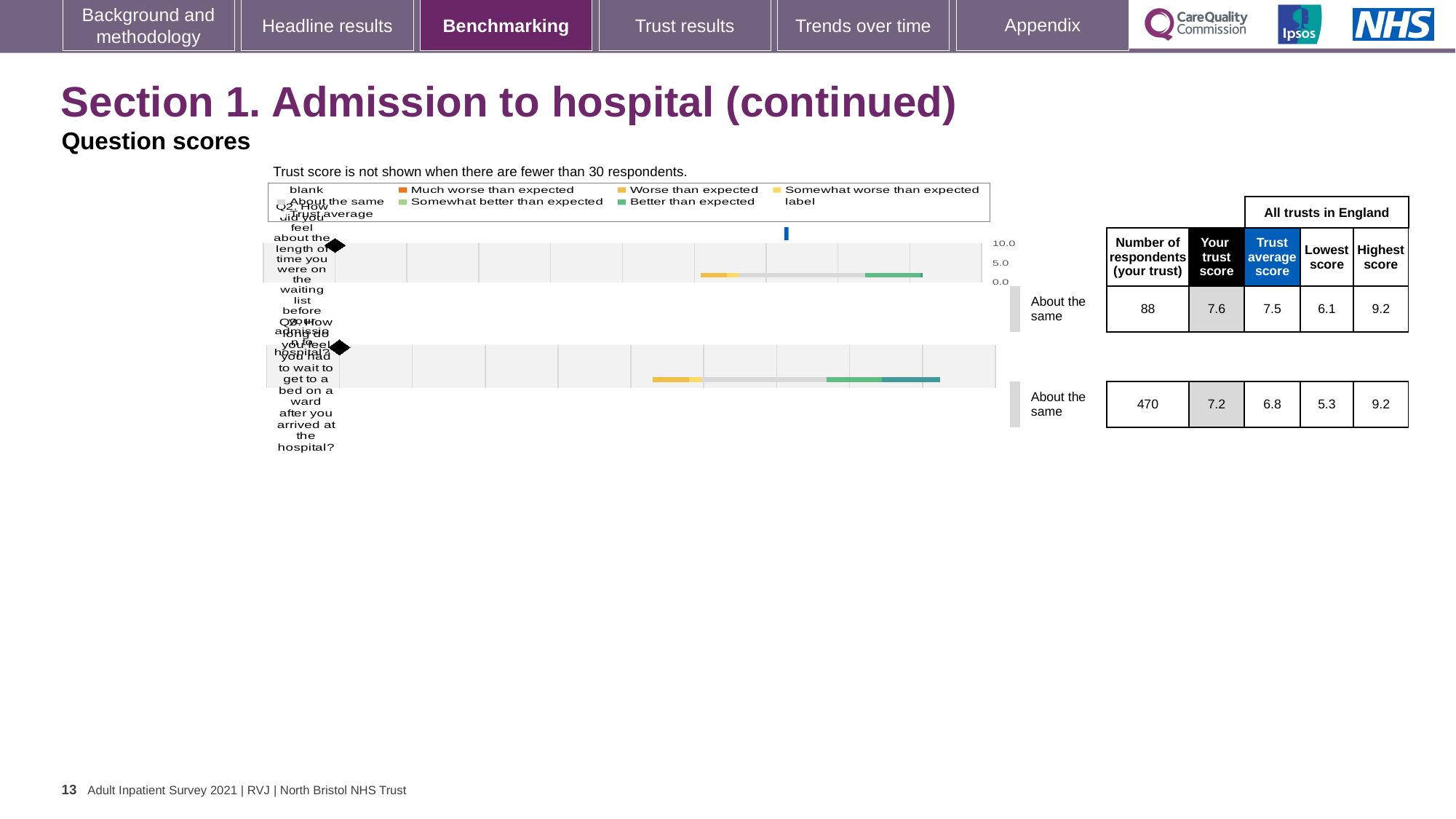
What is the lowest score across all trusts in England for Q2? 6.1 What colour represents 'Much worse than expected' in the chart legend? Orange What is the 'Your trust score' for Q3 (wait to get to a bed on a ward after arriving at the hospital)? 7.2 What is the difference between the trust score and the trust average score for Q3? 0.4 What is the maximum value shown on the score axis of the chart? 10.0 What is the 'Your trust score' for Q2 (length of time on the waiting list before admission)? 7.6 Which question has the higher 'Your trust score', Q2 or Q3? Q2 How is the trust's performance categorised for Q2 relative to expectations? About the same What kind of chart is used to show the question scores on this slide? Bar chart How many survey questions (bars) are shown in the benchmarking chart? 2 What is the trust average score for Q3? 6.8 How many respondents from the trust answered Q3? 470